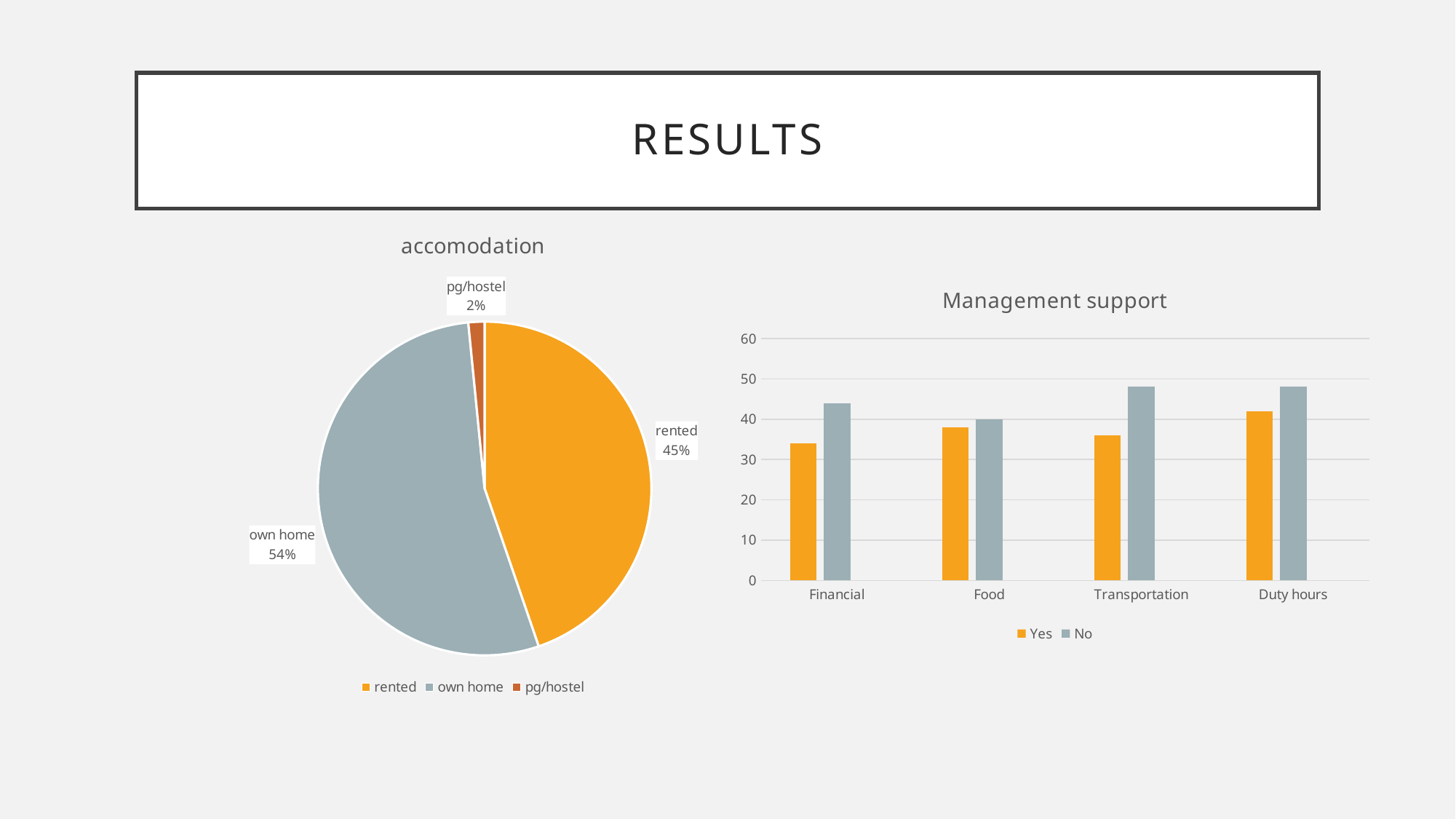
In the 'accomodation' pie chart, what share is labelled for 'rented'? 45% In the 'Management support' chart, how many series does the legend list? 2 In the 'Management support' chart, is the 'No' value for Financial greater or less than 40? greater In the 'accomodation' pie chart, what share is labelled for 'pg/hostel'? 2% What kind of chart is the 'accomodation' chart? pie chart In the 'Management support' chart, which is larger for Transportation, 'Yes' or 'No'? No What kind of chart is the 'Management support' chart? bar chart In the 'accomodation' pie chart, what share is labelled for 'own home'? 54% In the 'Management support' chart, how many categories are shown on the x axis? 4 In the 'accomodation' pie chart, which category has the smallest slice? pg/hostel In the 'accomodation' pie chart, how many slices are there? 3 In the 'accomodation' pie chart, which category has the largest slice? own home